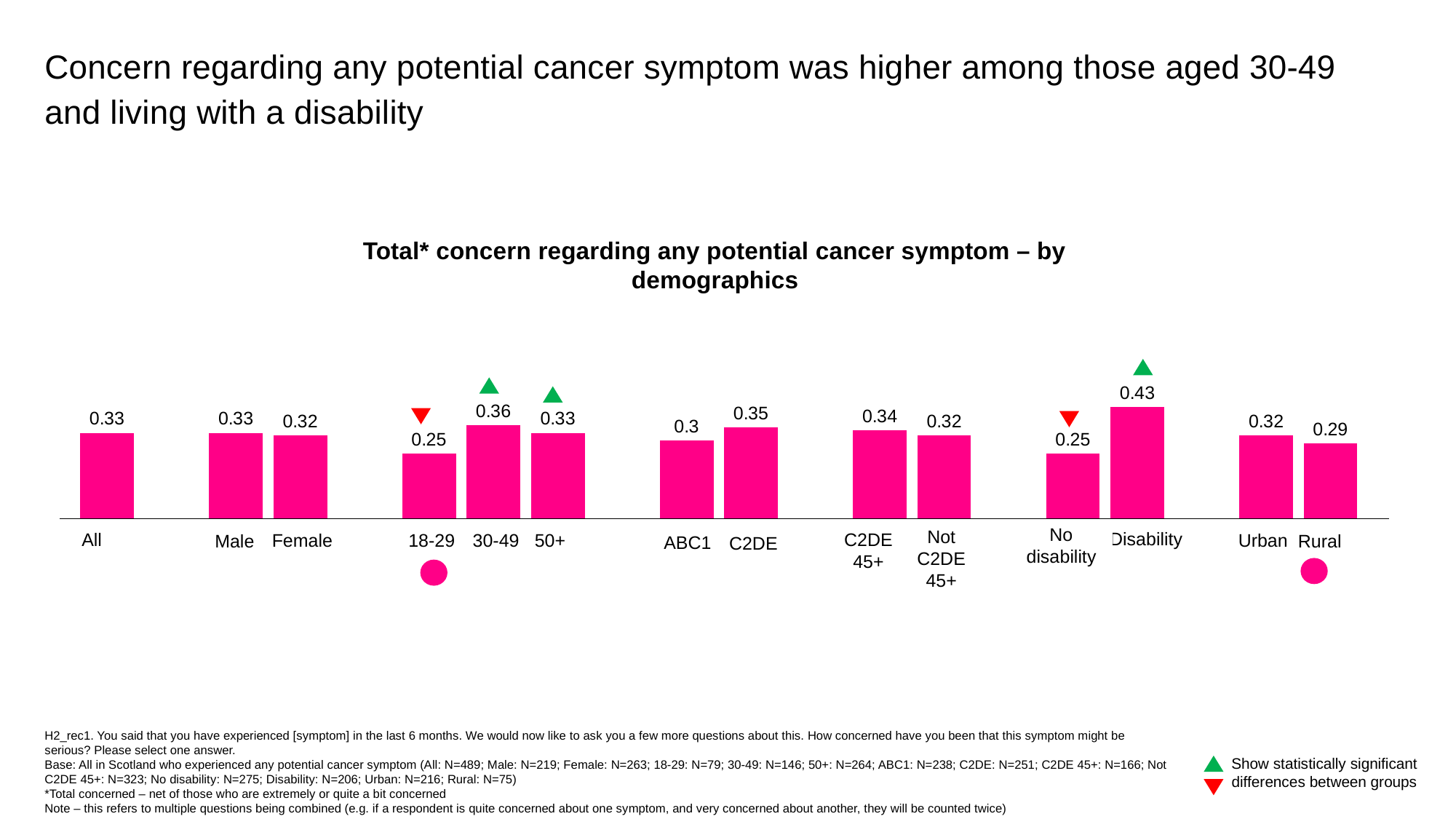
How many categories are shown on the chart? 14 Which category has the highest value? Disability What is the title of the chart? Total* concern regarding any potential cancer symptom – by demographics What is the difference between the values for Disability and No disability? 0.18 What kind of chart is shown on the slide? Bar chart What is the value for the Disability category? 0.43 Which has a larger value, Urban or Rural? Urban Which has a larger value, C2DE or ABC1? C2DE What is the value for the 18-29 category? 0.25 What is the value for the All category? 0.33 What is the value for the Rural category? 0.29 What is the difference between the values for 30-49 and 18-29? 0.11